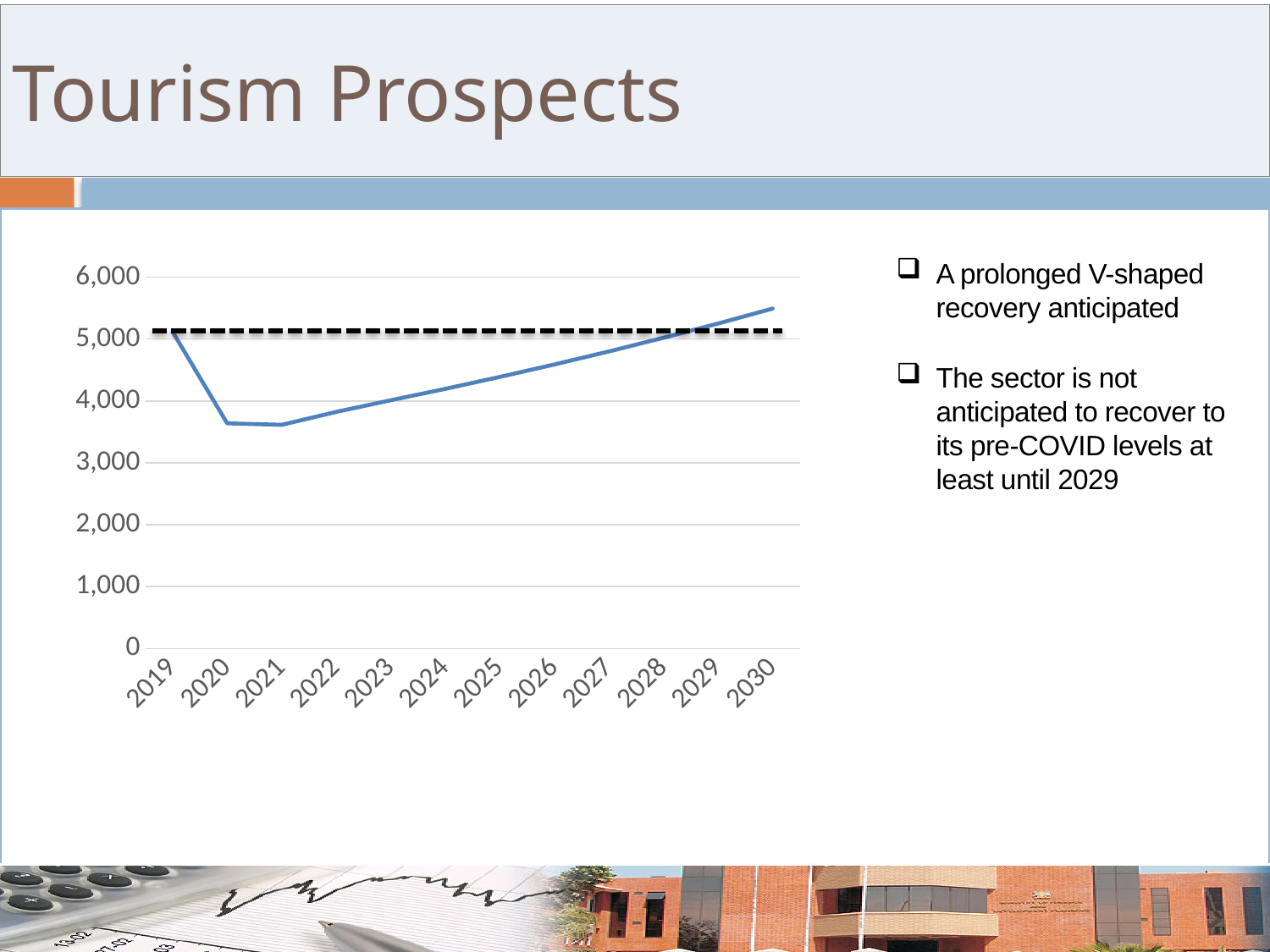
Which year has the highest value on the blue line? 2030 Is the value for 2025 greater or less than 4,000? greater Is the value for 2030 greater or less than 5,000? greater Is the value for 2027 greater or less than 5,000? less Which year has the larger value, 2020 or 2025? 2025 Does the blue line rise or fall from 2019 to 2020? fall What kind of chart is shown on the slide? line chart What is the highest value labelled on the y axis of the chart? 6,000 Does the blue line rise or fall from 2021 to 2030? rise How many years are shown on the x axis of the chart? 12